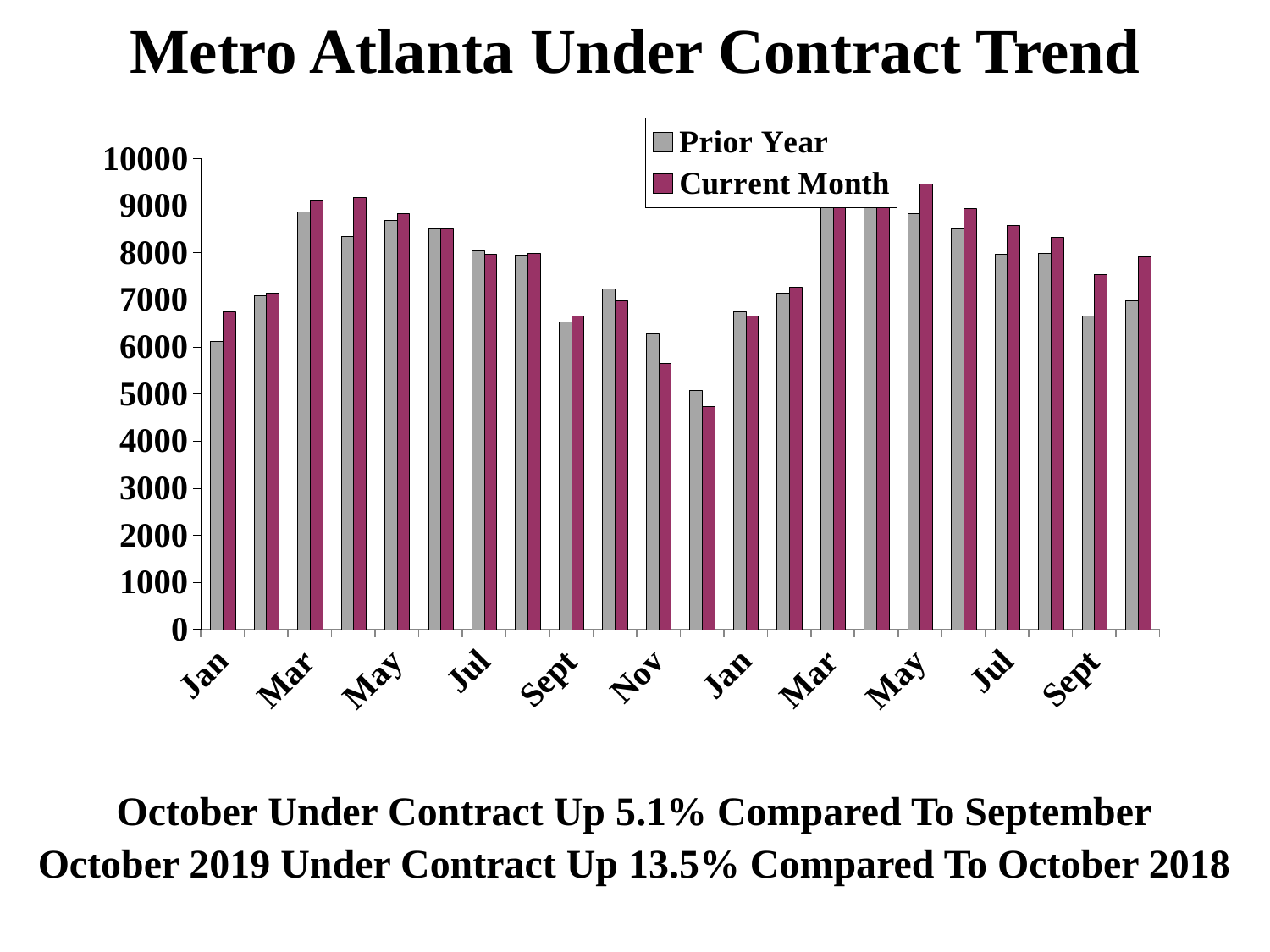
For the second Sept, which is larger: the Prior Year bar or the Current Month bar? Current Month Is the Current Month value for the first Nov greater or less than 6000? less Which series is shown in the darker (maroon) bars? Current Month Is the Current Month value for the second May greater or less than 9000? greater Is the Current Month value for the second Sept greater or less than 7000? greater Do the Current Month bars rise or fall from the first Jul to the first Nov? fall What kind of chart is shown on the slide? bar chart Which labeled month has the highest Current Month bar? the second May What is the title of the chart? Metro Atlanta Under Contract Trend How many series does the legend list? 2 For the first Nov, which is larger: the Prior Year bar or the Current Month bar? Prior Year